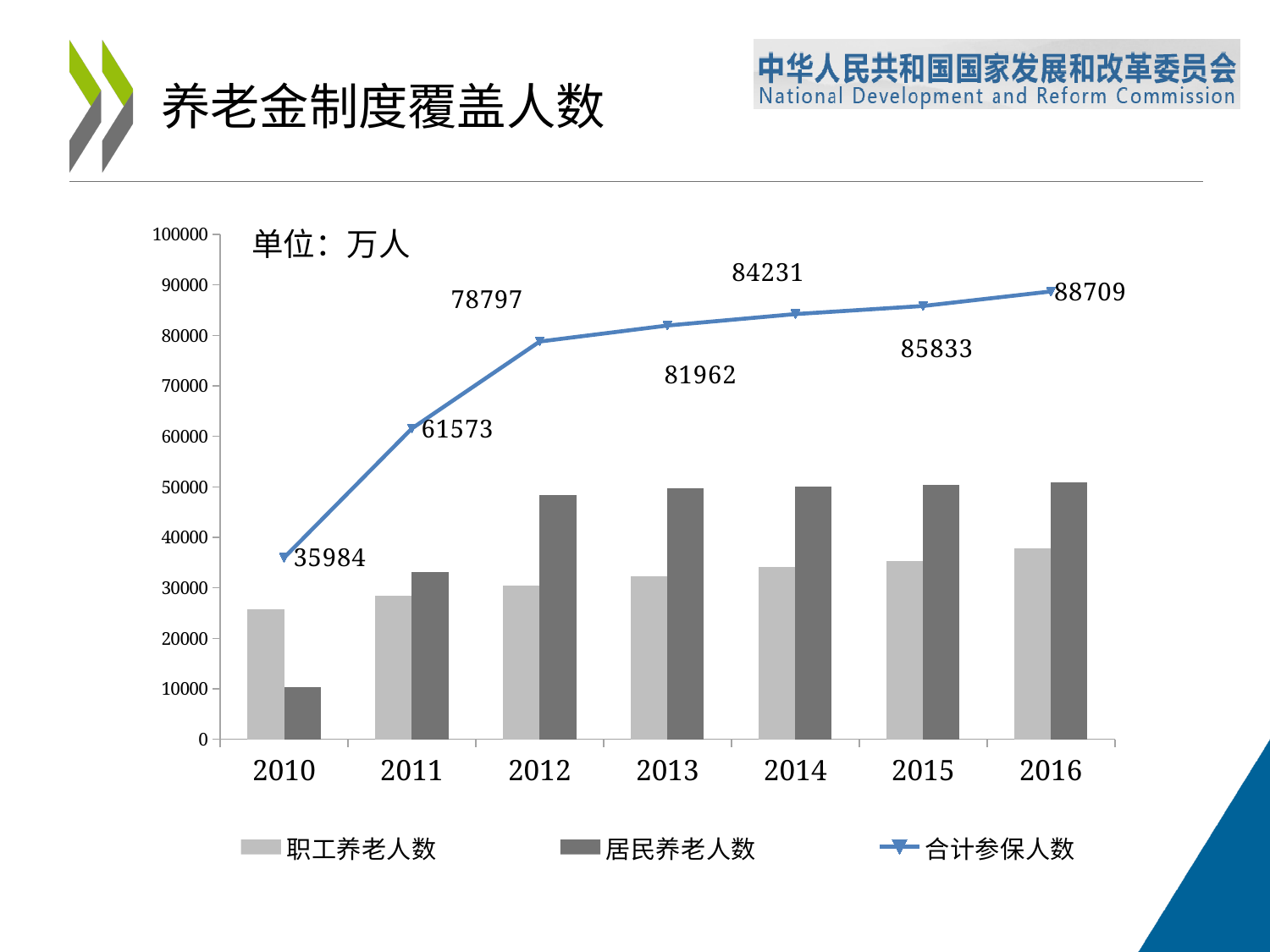
How many years are shown on the x axis? 7 What is the difference in 合计参保人数 between 2011 and 2010? 25589 What is the difference in 合计参保人数 between 2016 and 2015? 2876 How many series does the legend list? 3 What is the value of 合计参保人数 in 2013? 81962 Is the value of 居民养老人数 in 2012 greater or less than 50000? less What is the value of 合计参保人数 in 2016? 88709 In which year is 合计参保人数 the highest? 2016 What is the value of 合计参保人数 in 2010? 35984 Is the value of 职工养老人数 in 2010 greater or less than 30000? less In which year is 合计参保人数 the lowest? 2010 Which is larger: 合计参保人数 in 2012 or in 2014? 2014